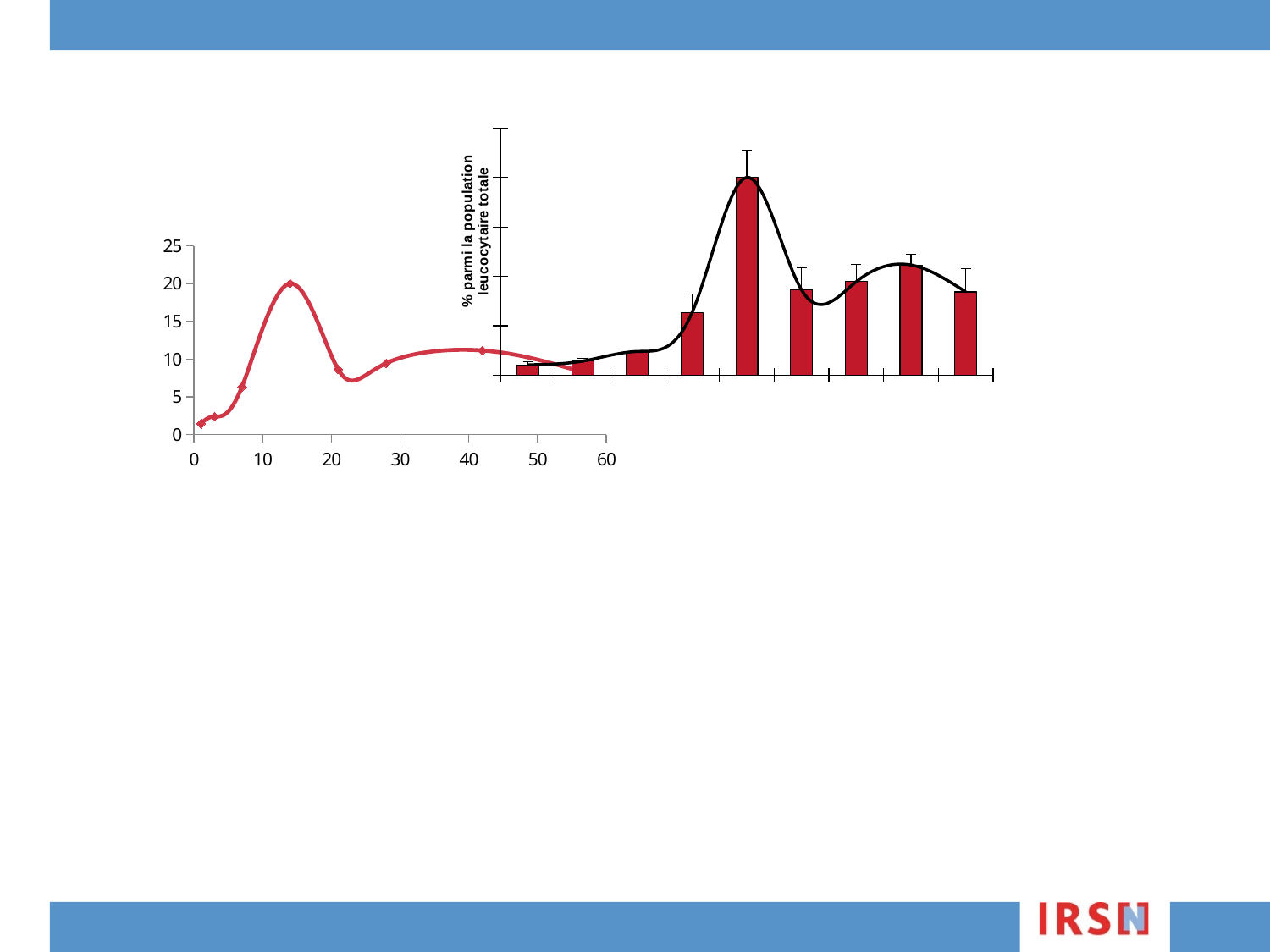
In the line chart on the left, is the value at the last point near x = 42 greater or less than 15? less In the line chart on the left, do the values rise or fall between x = 0 and x = 14? rise In the line chart on the left, is the peak value of the line near x = 14 greater or less than 15? greater In the bar chart on the right, how many bars are plotted? 9 In the bar chart on the right, which bar (counting from the left) is the tallest? the 5th bar What is the y-axis title of the bar chart on the right? % parmi la population leucocytaire totale In the line chart on the left, is the value at the point near x = 7 greater or less than 10? less What kind of chart is the chart on the right of the slide? combination bar and line chart What kind of chart is the chart on the left of the slide? line chart In the line chart on the left, what is the highest value shown on the y axis? 25